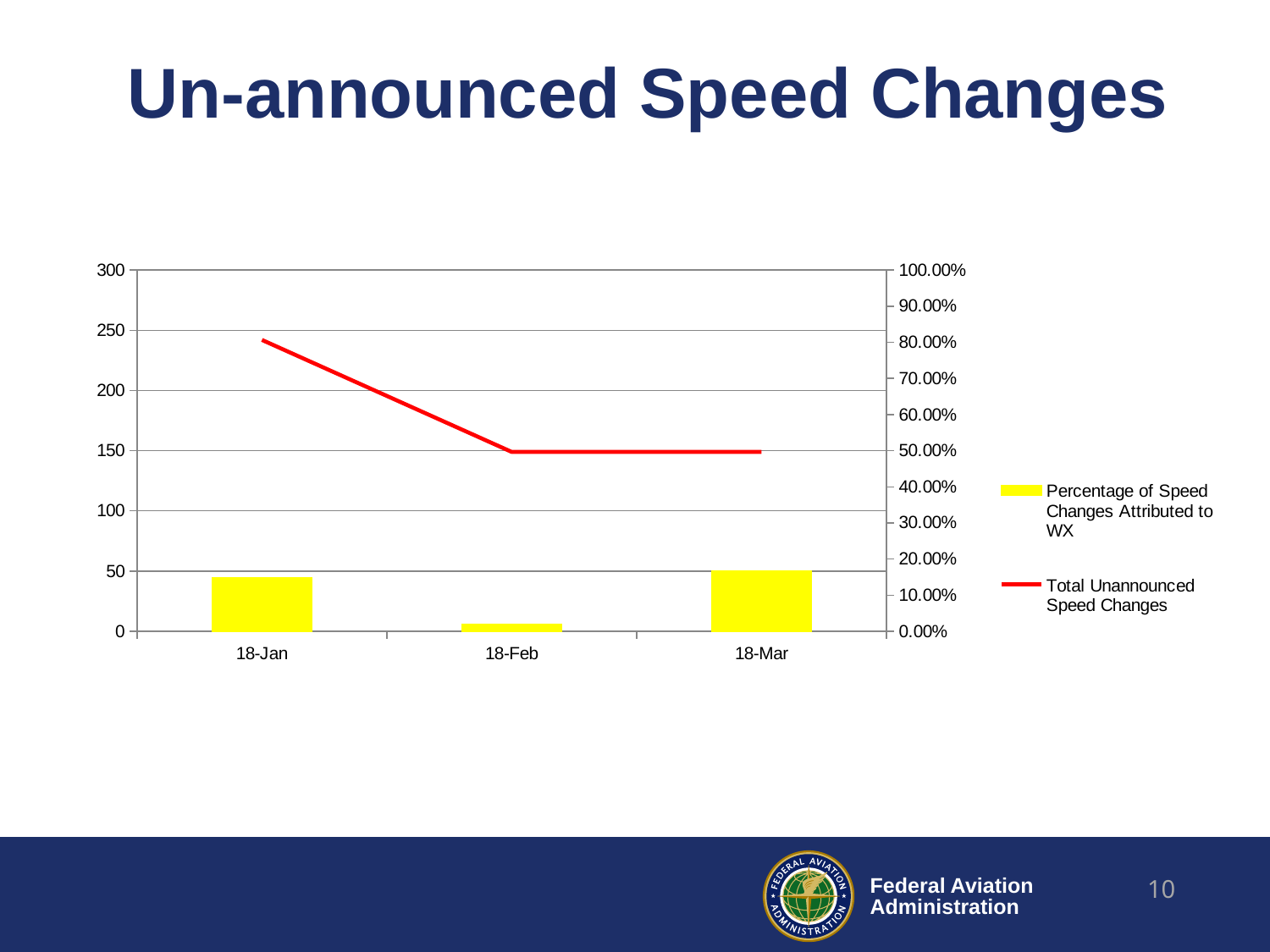
On the left axis scale, is the Total Unannounced Speed Changes line at 18-Jan greater or less than 200? greater On the left axis scale, is the bar for 18-Feb greater or less than 50? less Which month has the taller bar, 18-Jan or 18-Feb? 18-Jan How many months are shown on the x axis of the chart? 3 How many series does the chart legend list? 2 What is the title of the slide containing the chart? Un-announced Speed Changes What colour is the Total Unannounced Speed Changes line in the chart? Red Which month has the lowest bar for Percentage of Speed Changes Attributed to WX? 18-Feb How does the Total Unannounced Speed Changes line change from 18-Jan to 18-Mar? It falls from 18-Jan to 18-Feb, then stays flat to 18-Mar Is the Total Unannounced Speed Changes line higher at 18-Jan or at 18-Mar? 18-Jan In which month is the Total Unannounced Speed Changes line at its highest? 18-Jan What kind of chart is shown on the slide? A combination bar and line chart